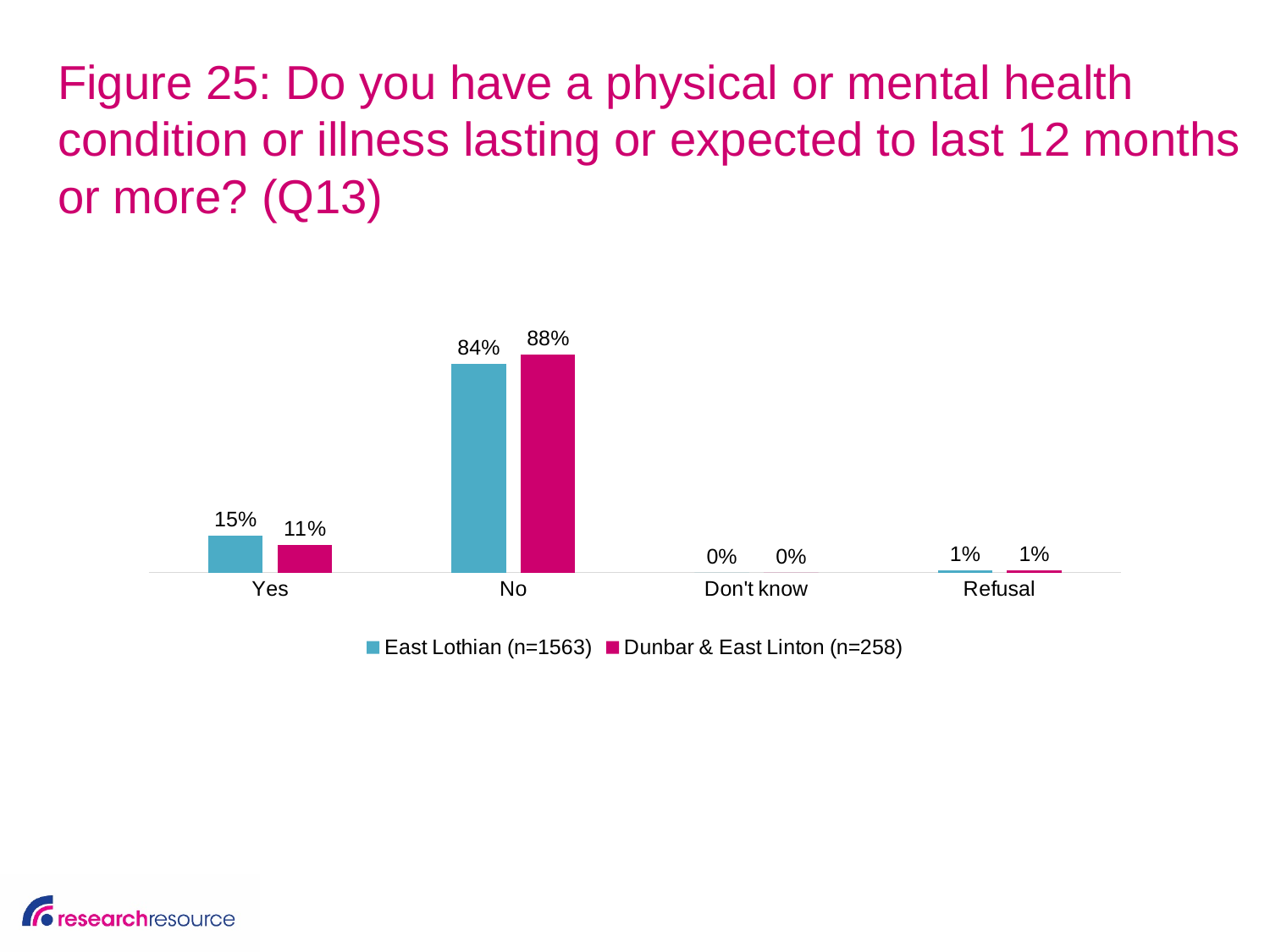
How many series does the legend list? 2 What is the value for Dunbar & East Linton (n=258) in the Yes category? 11% How many categories are shown on the x axis? 4 In the Yes category, which series has the larger value, East Lothian (n=1563) or Dunbar & East Linton (n=258)? East Lothian (n=1563) What is the value for East Lothian (n=1563) in the Refusal category? 1% What kind of chart is shown on the slide? Bar chart What is the value for Dunbar & East Linton (n=258) in the No category? 88% What is the difference between the East Lothian (n=1563) and Dunbar & East Linton (n=258) values in the No category? 4% Which category has the highest value for East Lothian (n=1563)? No What is the difference between the East Lothian (n=1563) and Dunbar & East Linton (n=258) values in the Yes category? 4% Which category has the lowest value for Dunbar & East Linton (n=258)? Don't know What is the value for East Lothian (n=1563) in the Yes category? 15%